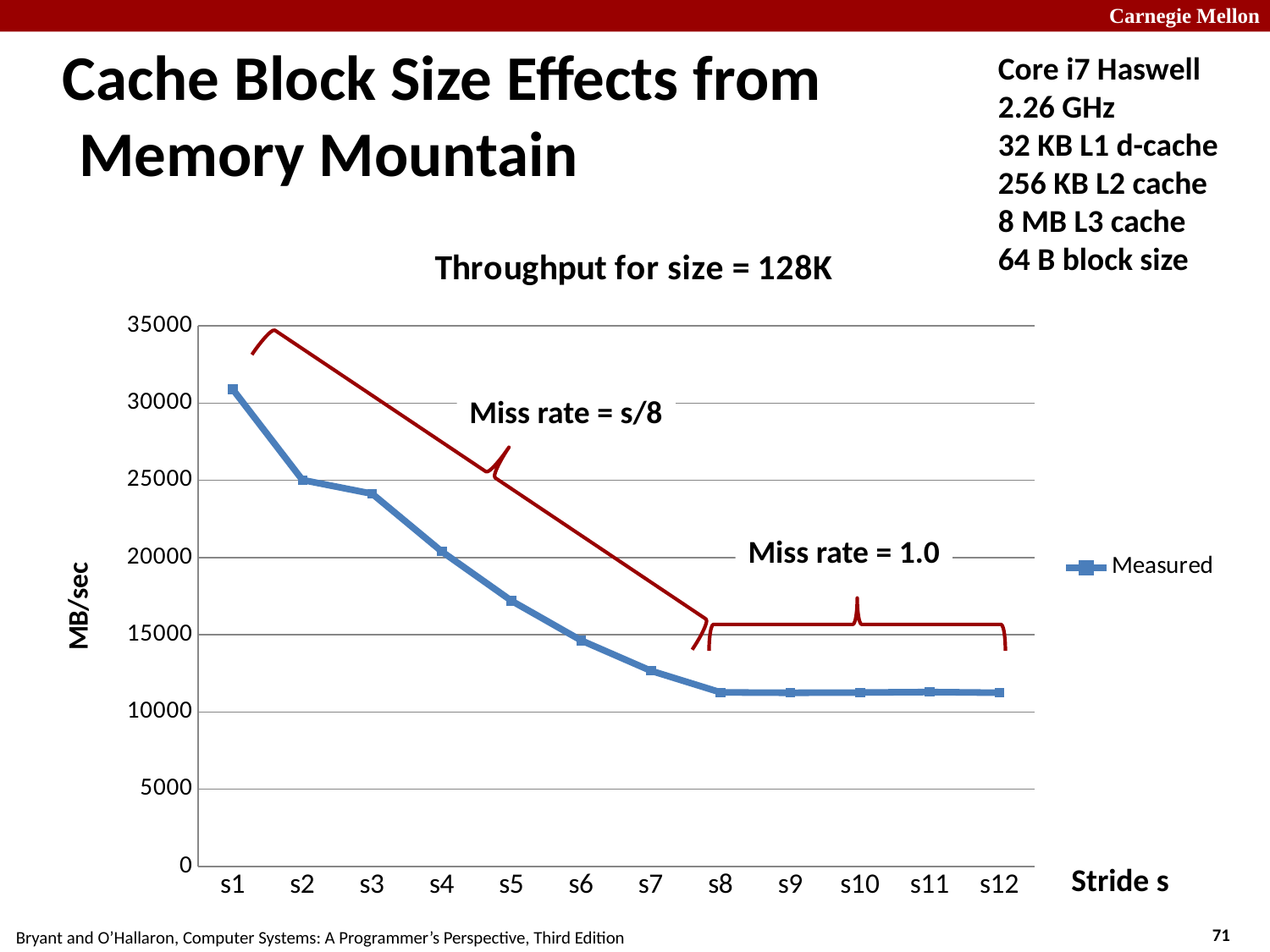
How many stride categories are plotted along the x axis? 12 Is the measured value for s1 greater or less than 25000? greater What series does the legend list? Measured Is the measured value for s12 greater or less than 15000? less How many series does the legend list? 1 Which stride has the highest measured throughput? s1 Is the measured value for s8 greater or less than 10000? greater What kind of chart is shown on the slide? line chart What is the title of the chart? Throughput for size = 128K Do the measured values rise or fall as the stride increases from s1 to s8? fall Which has the larger measured throughput, s3 or s7? s3